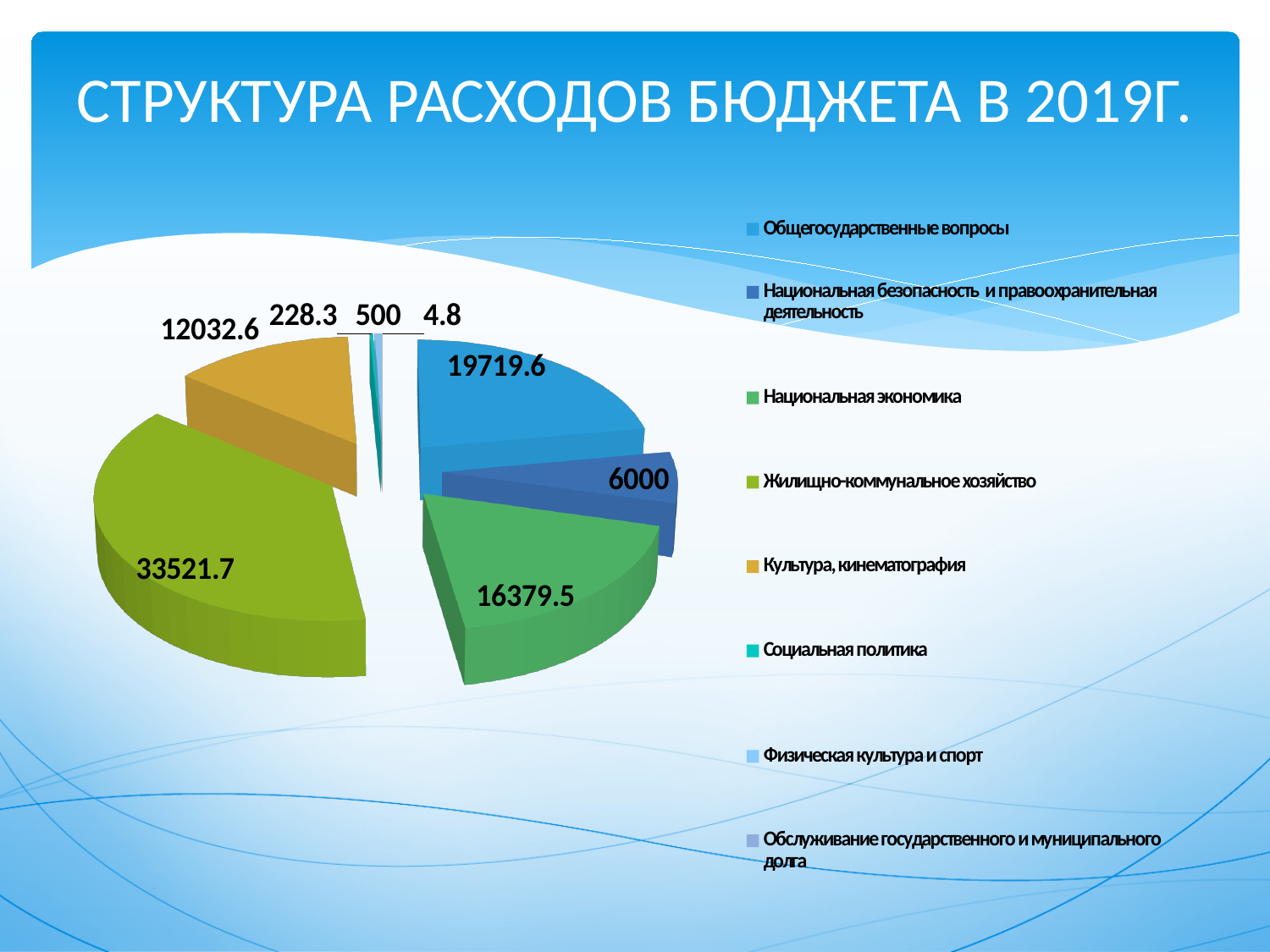
Which is larger: Национальная экономика or Культура, кинематография? Национальная экономика How many categories does the legend list? 8 What is the value for Культура, кинематография? 12032.6 Which category has the largest slice of the pie? Жилищно-коммунальное хозяйство What is the value for Общегосударственные вопросы? 19719.6 What type of chart is shown on the slide? Pie chart What is the difference between the values for Жилищно-коммунальное хозяйство and Общегосударственные вопросы? 13802.1 What is the value for Национальная безопасность и правоохранительная деятельность? 6000 Which category has the smallest value? Обслуживание государственного и муниципального долга What is the value for Жилищно-коммунальное хозяйство? 33521.7 What is the value for Национальная экономика? 16379.5 What is the title of the slide? СТРУКТУРА РАСХОДОВ БЮДЖЕТА В 2019Г.